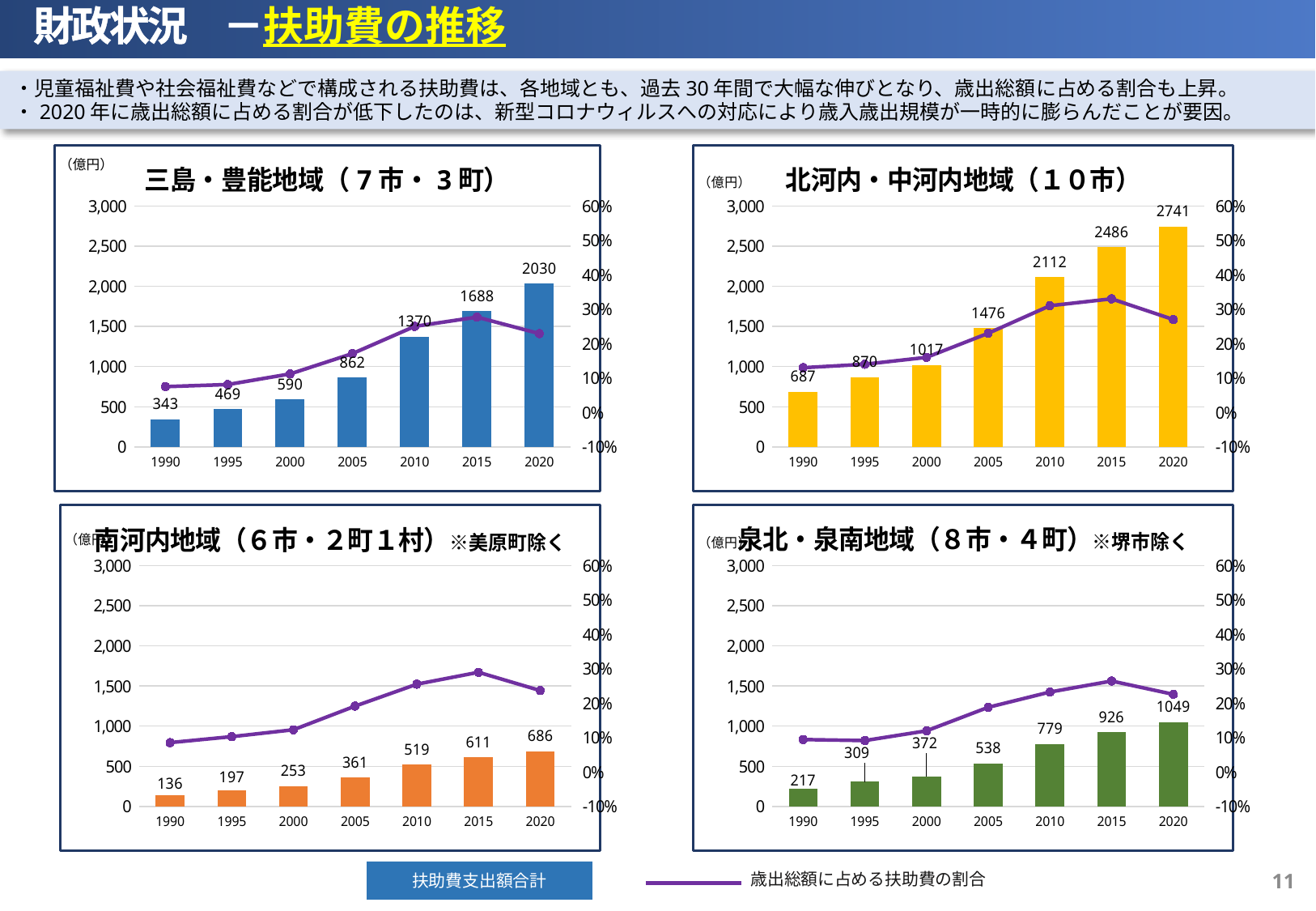
In the 泉北・泉南地域（８市・４町） chart, what is the difference between the bar values for 2010 and 2005? 241 Do the bar values in the 三島・豊能地域（７市・３町） chart rise or fall from 1990 to 2020? rise What kind of chart is used for the 扶助費支出額合計 series in the 泉北・泉南地域（８市・４町） chart? bar chart In the 北河内・中河内地域（１０市） chart, is the line value for 2020 greater or less than 20%? greater In the 三島・豊能地域（７市・３町） chart, what is the difference between the bar values for 2020 and 2015? 342 How many years are shown on the x axis of the 南河内地域（６市・２町１村） chart? 7 In the 泉北・泉南地域（８市・４町） chart, which year has the highest bar? 2020 In the 北河内・中河内地域（１０市） chart, which year has the lowest bar? 1990 In the 三島・豊能地域（７市・３町） chart, what is the value of the bar for 2020? 2030 Which is larger: the 2020 bar in the 南河内地域 chart or the 2020 bar in the 泉北・泉南地域 chart? 泉北・泉南地域 In the 北河内・中河内地域（１０市） chart, what is the value of the bar for 2005? 1476 In the 南河内地域（６市・２町１村） chart, what is the value of the bar for 1990? 136